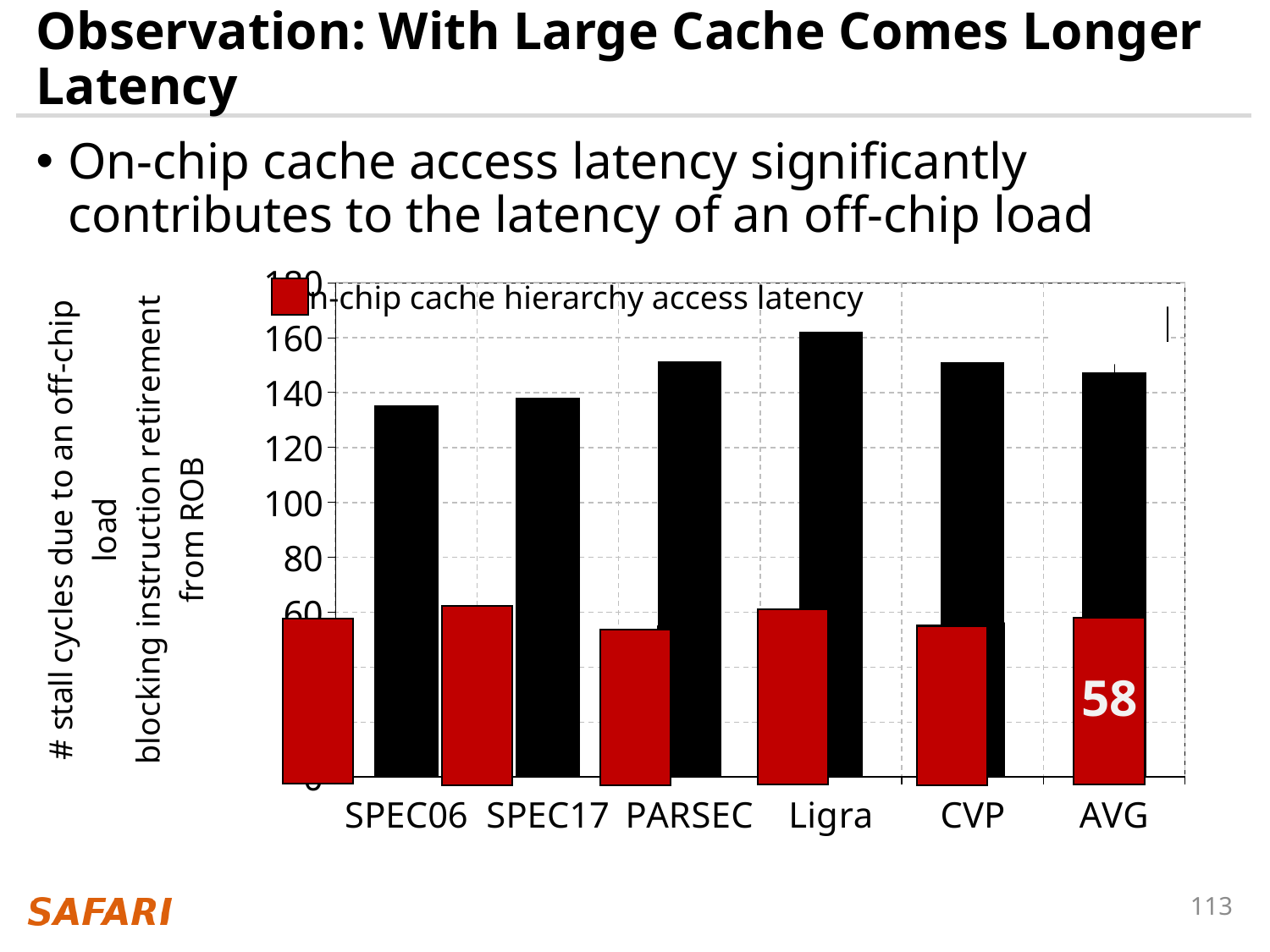
What kind of chart is shown on the slide? bar chart What does the legend say the red bars represent? On-chip cache hierarchy access latency Is the black bar for Ligra greater or less than 140? greater Which is larger, the black bar for Ligra or the black bar for SPEC06? Ligra Is the black bar for SPEC06 greater or less than 140? less What colour is the bar that carries the data label 58? red How many categories are shown on the x axis of the chart? 6 Which is larger, the black bar for PARSEC or the black bar for SPEC17? PARSEC Which category has the tallest black bar? Ligra What is the value printed on the red bar for AVG? 58 Is the black bar for AVG greater or less than 140? greater